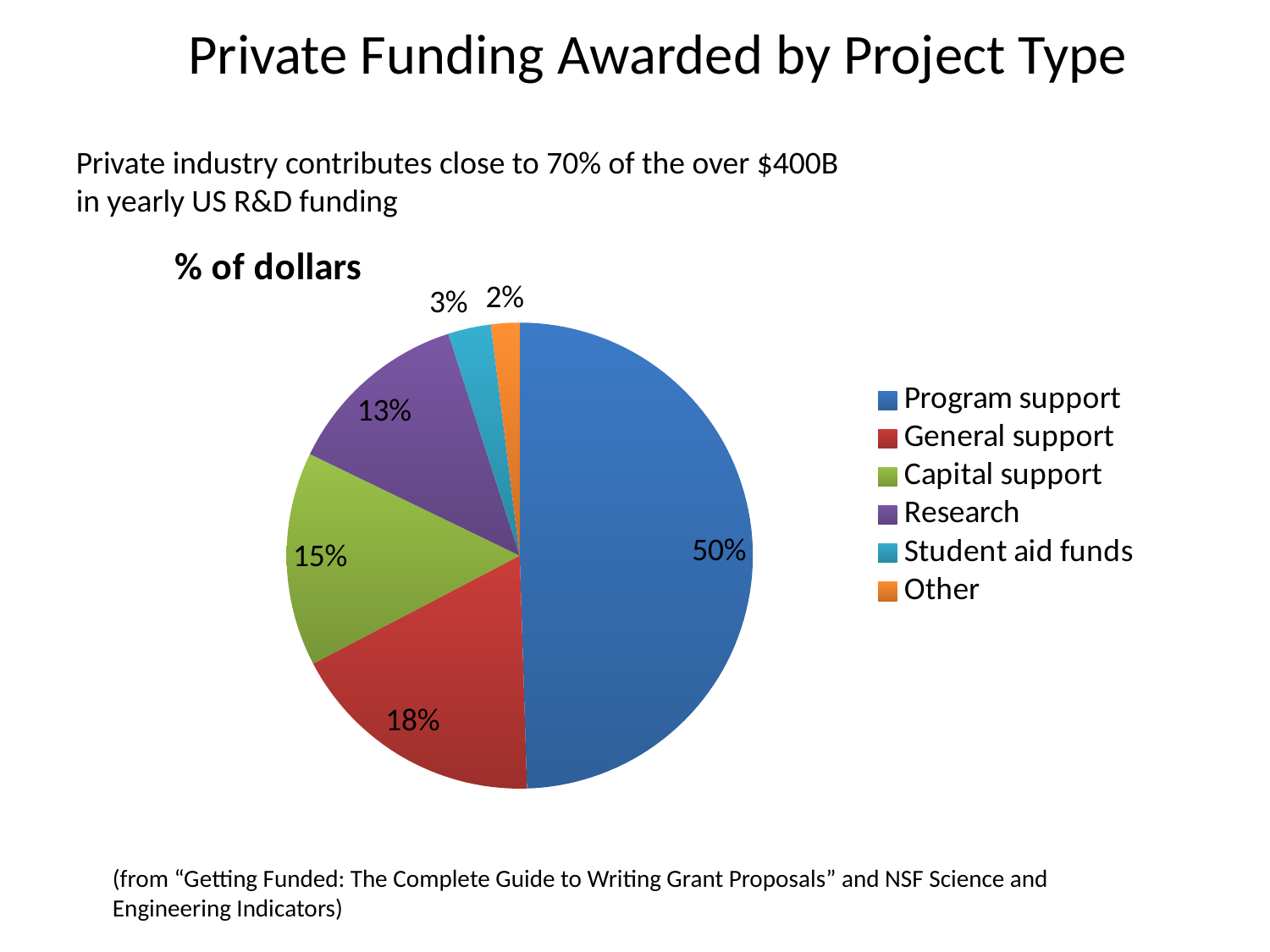
Which project type receives the smallest share of dollars? Other How many project types are shown in the pie chart? 6 What share of dollars does General support receive? 18% What kind of chart is shown on the slide? Pie chart What share of dollars does Research receive? 13% What share of dollars does Program support receive? 50% Which receives a larger share of dollars, Capital support or Research? Capital support What is the difference in percentage points between Program support and General support? 32 What is the title of the chart? % of dollars Which project type receives the largest share of dollars? Program support